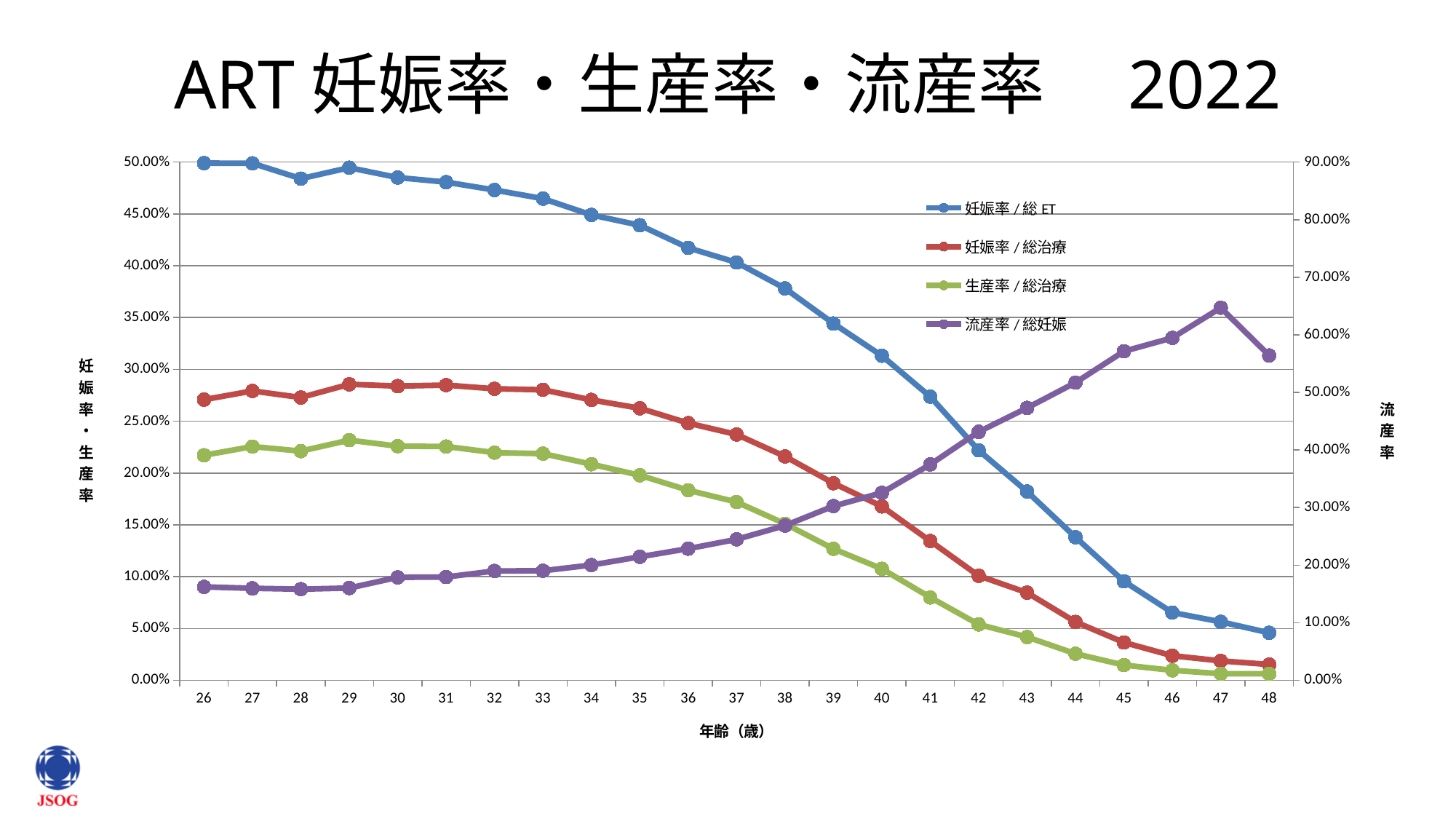
Is the value of 生産率 / 総治療 at age 36 greater or less than 20.00%? less What kind of chart is shown on the slide? line chart How many series does the legend list? 4 At which age is the 妊娠率 / 総 ET series at its lowest value? 48 Is the value of 妊娠率 / 総 ET at age 40 greater or less than 30.00%? greater At which age does the 流産率 / 総妊娠 series reach its highest value? 47 Does the 流産率 / 総妊娠 series generally rise or fall as age increases from 26 to 47? rise What is the label of the right-hand vertical axis? 流産率 At age 30, which is larger: 妊娠率 / 総治療 or 生産率 / 総治療? 妊娠率 / 総治療 Does the 妊娠率 / 総 ET series rise or fall as age increases from 26 to 48? fall Is the value of 流産率 / 総妊娠 at age 47 greater or less than 60.00% on the right axis? greater How many age points are plotted along the x axis? 23